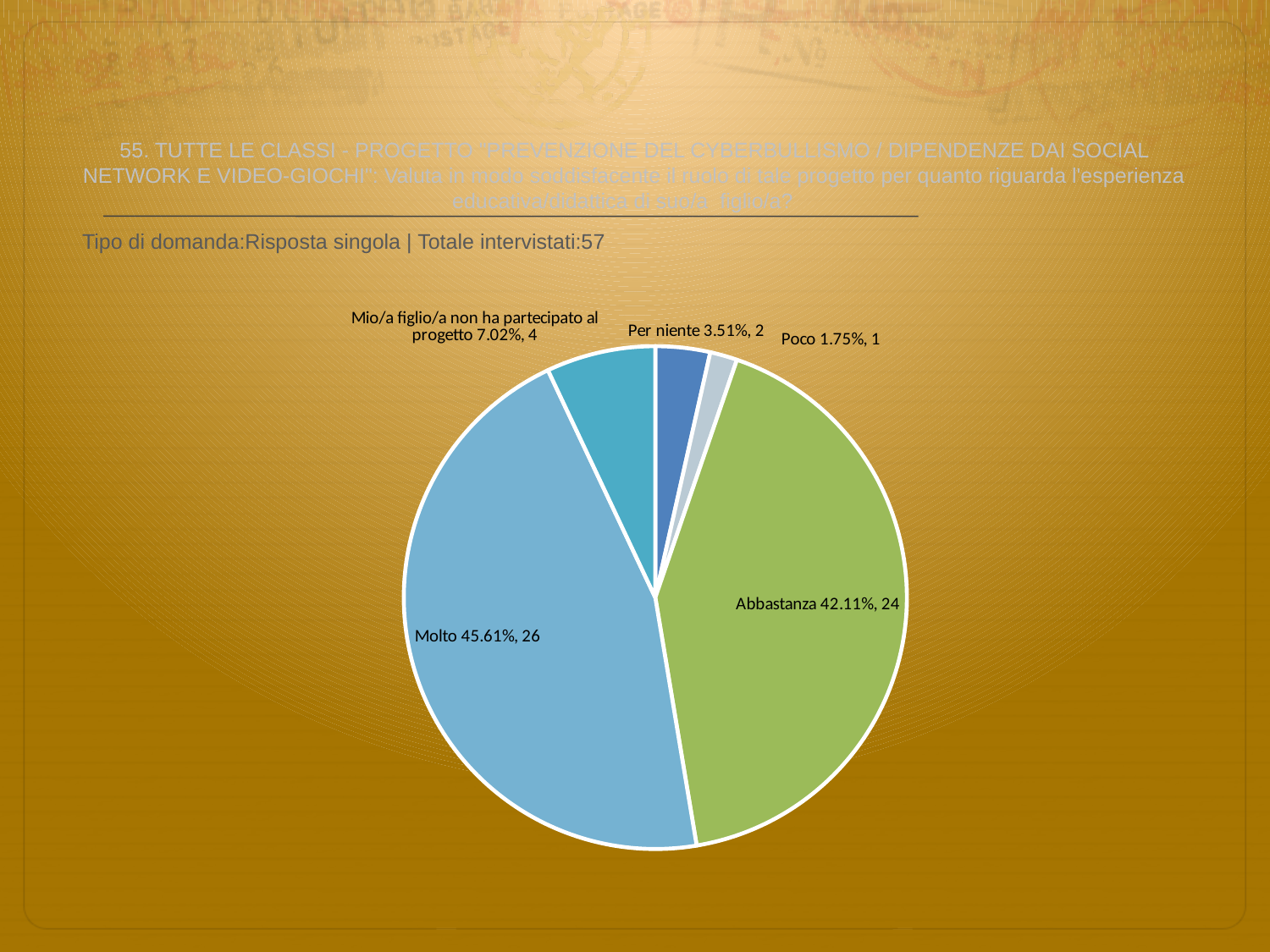
What percentage share does the "Molto" slice have? 45.61% How many respondents chose "Mio/a figlio/a non ha partecipato al progetto"? 4 How many slices does the pie chart have? 5 Which category has the smallest slice? Poco What percentage share does the "Abbastanza" slice have? 42.11% How many respondents answered "Per niente"? 2 What is the difference in respondent count between "Molto" and "Abbastanza"? 2 What percentage share does the "Poco" slice have? 1.75% How many respondents answered "Abbastanza"? 24 Which category has the largest slice? Molto Which has more respondents, "Per niente" or "Mio/a figlio/a non ha partecipato al progetto"? Mio/a figlio/a non ha partecipato al progetto What kind of chart is shown on the slide? pie chart